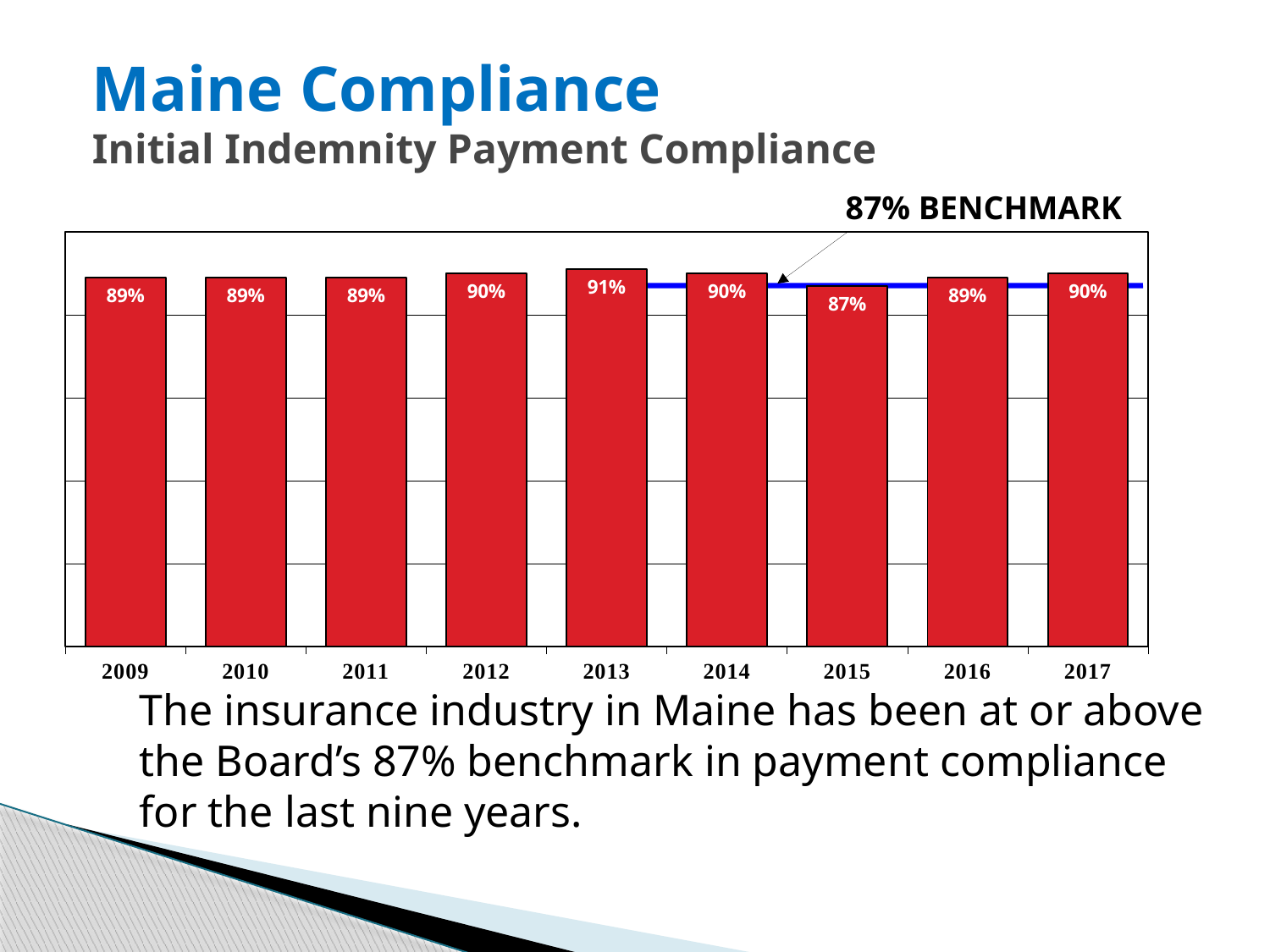
What is the compliance value for 2009? 89% Which year has the lowest compliance value? 2015 What colour are the bars in the chart? Red What kind of chart is shown on the slide? Bar chart What is the difference between the compliance values for 2013 and 2015? 4% What benchmark value does the horizontal line on the chart represent? 87% What is the compliance value for 2017? 90% How many years are shown on the chart? 9 What is the compliance value for 2013? 91% What is the compliance value for 2015? 87% Which is larger, the compliance value for 2014 or for 2015? 2014 Which year has the highest compliance value? 2013